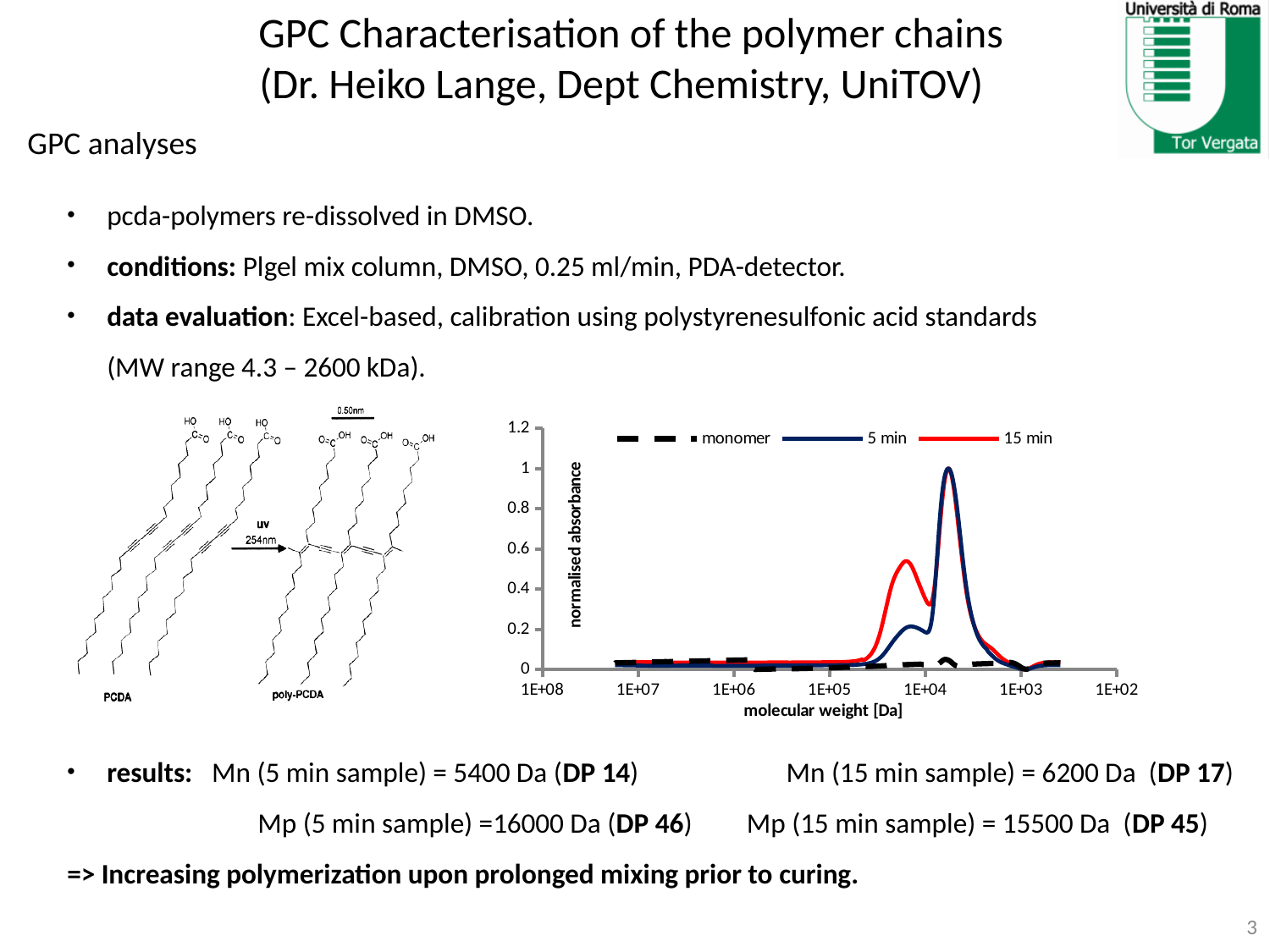
Is the maximum value of the 5 min series greater or less than 0.8? greater Is the secondary peak of the 5 min series, located between 1E+05 and 1E+04 Da, greater or less than 0.4? less Is the maximum value of the monomer series greater or less than 0.2? less Which series has the higher secondary peak between 1E+05 and 1E+04 Da, 5 min or 15 min? 15 min What is the label of the chart's vertical axis? normalised absorbance How many series does the chart legend list? 3 Which series has the lowest maximum normalised absorbance? monomer What kind of chart is shown on the slide? line chart What are the three series named in the chart legend? monomer, 5 min, 15 min